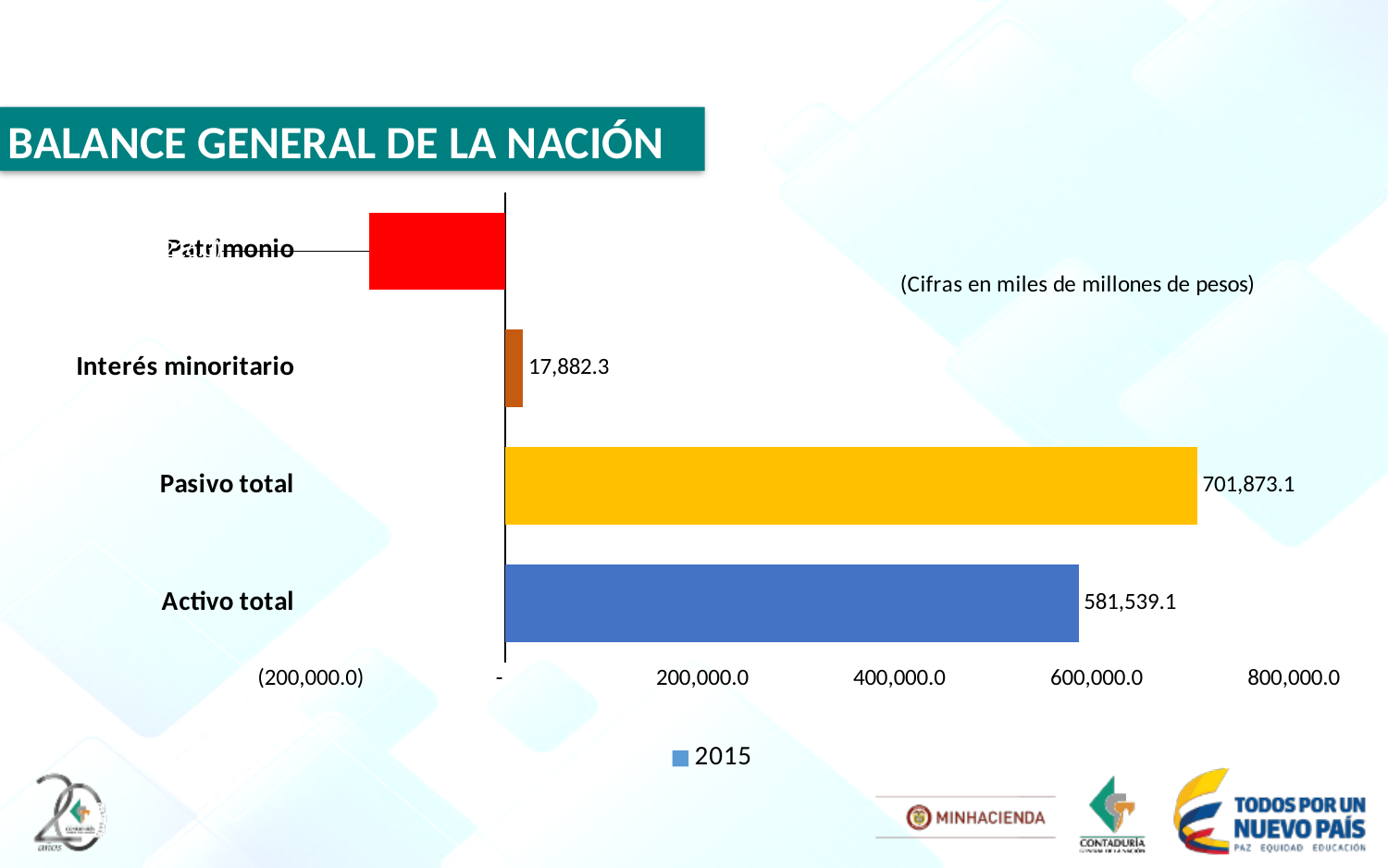
Which category has the lowest value? Patrimonio How many categories are shown in the chart? 4 What year does the legend entry show? 2015 What is the value for Activo total? 581,539.1 What is the value for Interés minoritario? 17,882.3 Which is larger, Activo total or Interés minoritario? Activo total Is the value for Patrimonio greater or less than (200,000.0)? greater What is the value for Pasivo total? 701,873.1 Which category has the highest value? Pasivo total What is the difference between Pasivo total and Activo total? 120,334.0 What kind of chart is shown on the slide? bar chart How many series does the legend list? 1